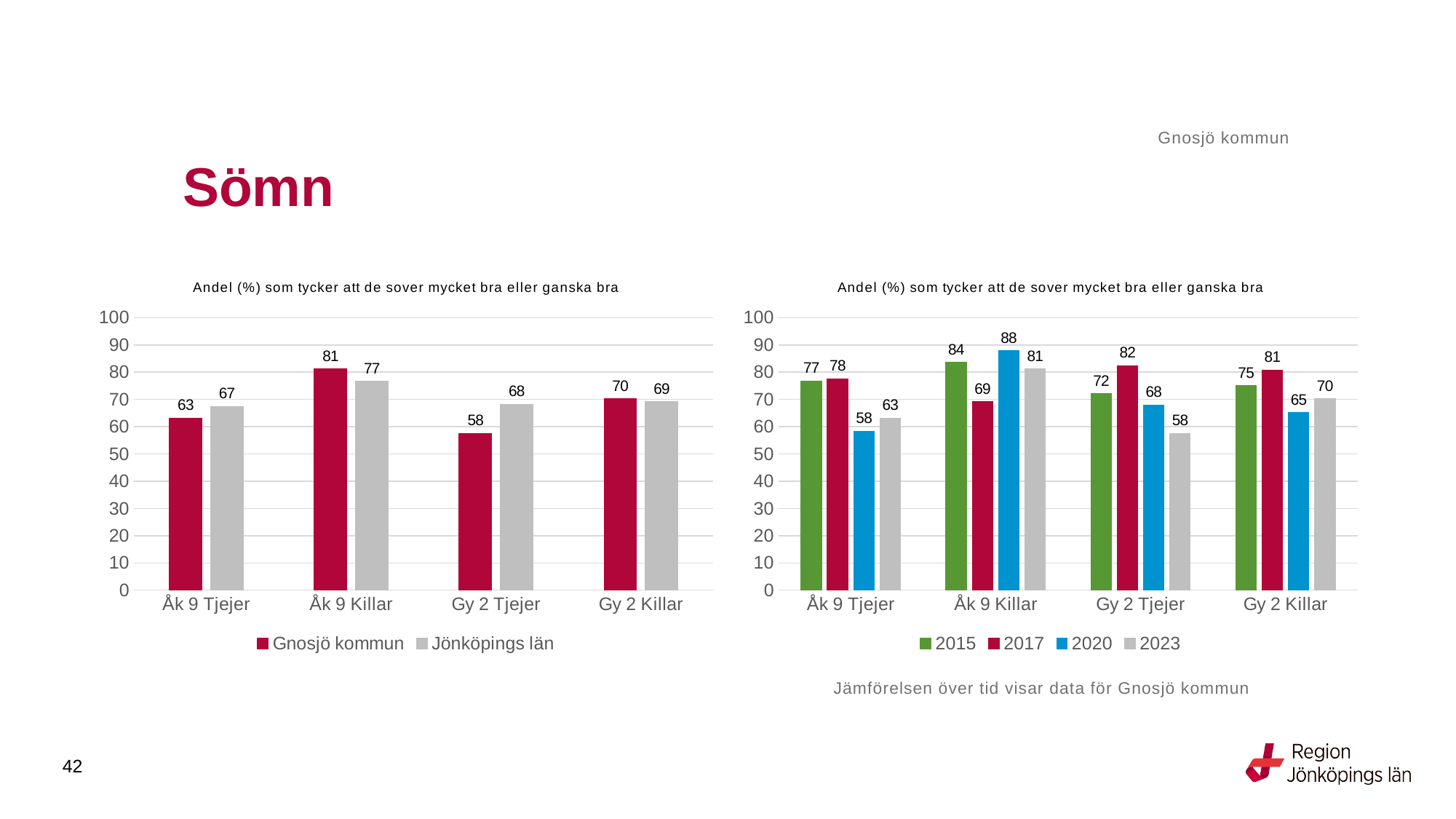
In the left chart, what is the difference between Jönköpings län and Gnosjö kommun for Gy 2 Tjejer? 10 In the left chart, which is larger for Åk 9 Tjejer: Gnosjö kommun or Jönköpings län? Jönköpings län How many series does the legend of the right chart list? 4 In the right chart, which year has the highest value for Gy 2 Tjejer? 2017 In the right chart, do the values for Åk 9 Tjejer rise or fall from 2017 to 2020? fall In the right chart, what is the value for 2020 for Åk 9 Killar? 88 In the left chart, what is the value for Gnosjö kommun for Åk 9 Killar? 81 How many categories are shown on the x axis of the left chart? 4 In the right chart, what is the difference between the 2017 and 2023 values for Gy 2 Tjejer? 24 In the left chart, which category has the lowest value for Gnosjö kommun? Gy 2 Tjejer What kind of chart is the right chart? bar chart In the left chart, what is the value for Jönköpings län for Gy 2 Tjejer? 68